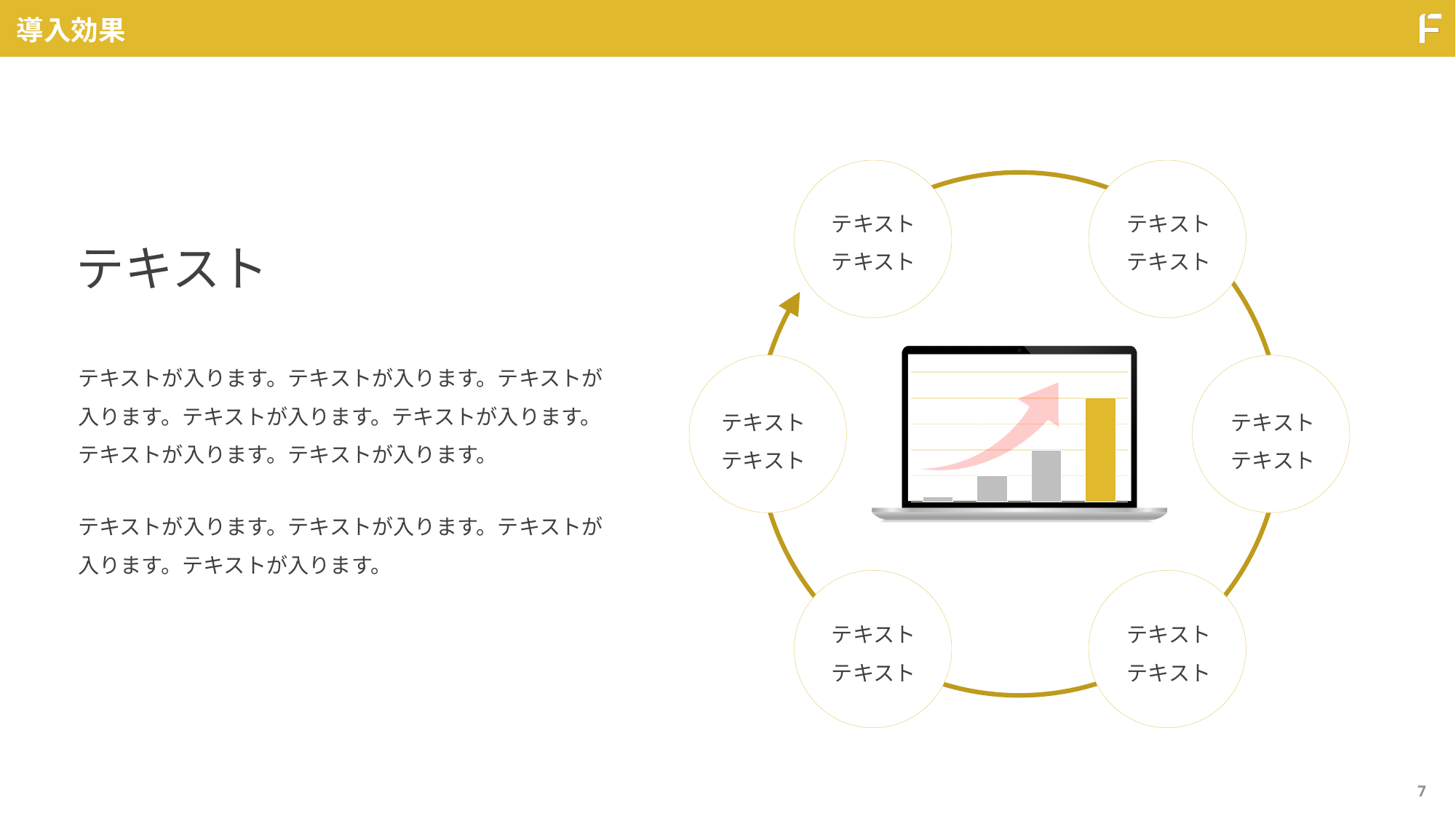
Which bar in the chart on the laptop screen is the tallest, the leftmost or the rightmost? rightmost What kind of chart is shown on the laptop screen in the illustration? bar chart Do the bars in the chart on the laptop screen rise or fall from left to right? rise How many bars are shown in the chart on the laptop screen? 4 What colour is the tallest bar in the chart on the laptop screen? yellow